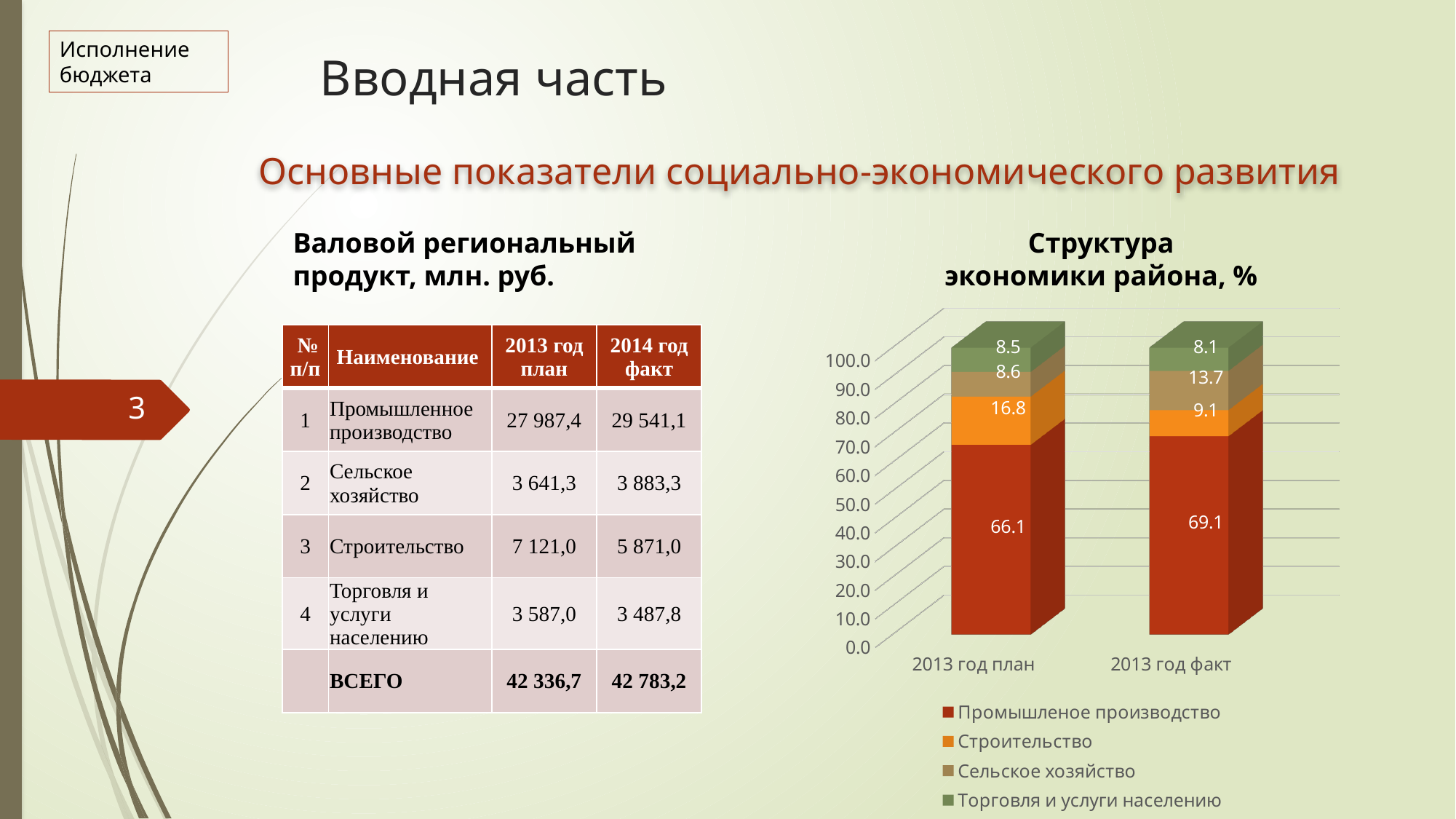
What is the value for Строительство in 2013 год факт? 9.1 What is the value for Торговля и услуги населению in 2013 год план? 8.5 Which series has the largest value in 2013 год факт? Промышленое производство How many categories are shown on the x axis of the chart? 2 How many series does the chart legend list? 4 What is the difference between the Строительство values for 2013 год план and 2013 год факт? 7.7 What is the title of the chart on the slide? Структура экономики района, % Which is larger: Сельское хозяйство in 2013 год план or in 2013 год факт? 2013 год факт What is the value for Промышленое производство in 2013 год план? 66.1 What kind of chart is shown on the slide? stacked bar chart What is the value for Сельское хозяйство in 2013 год факт? 13.7 Which series has the smallest value in 2013 год факт? Торговля и услуги населению